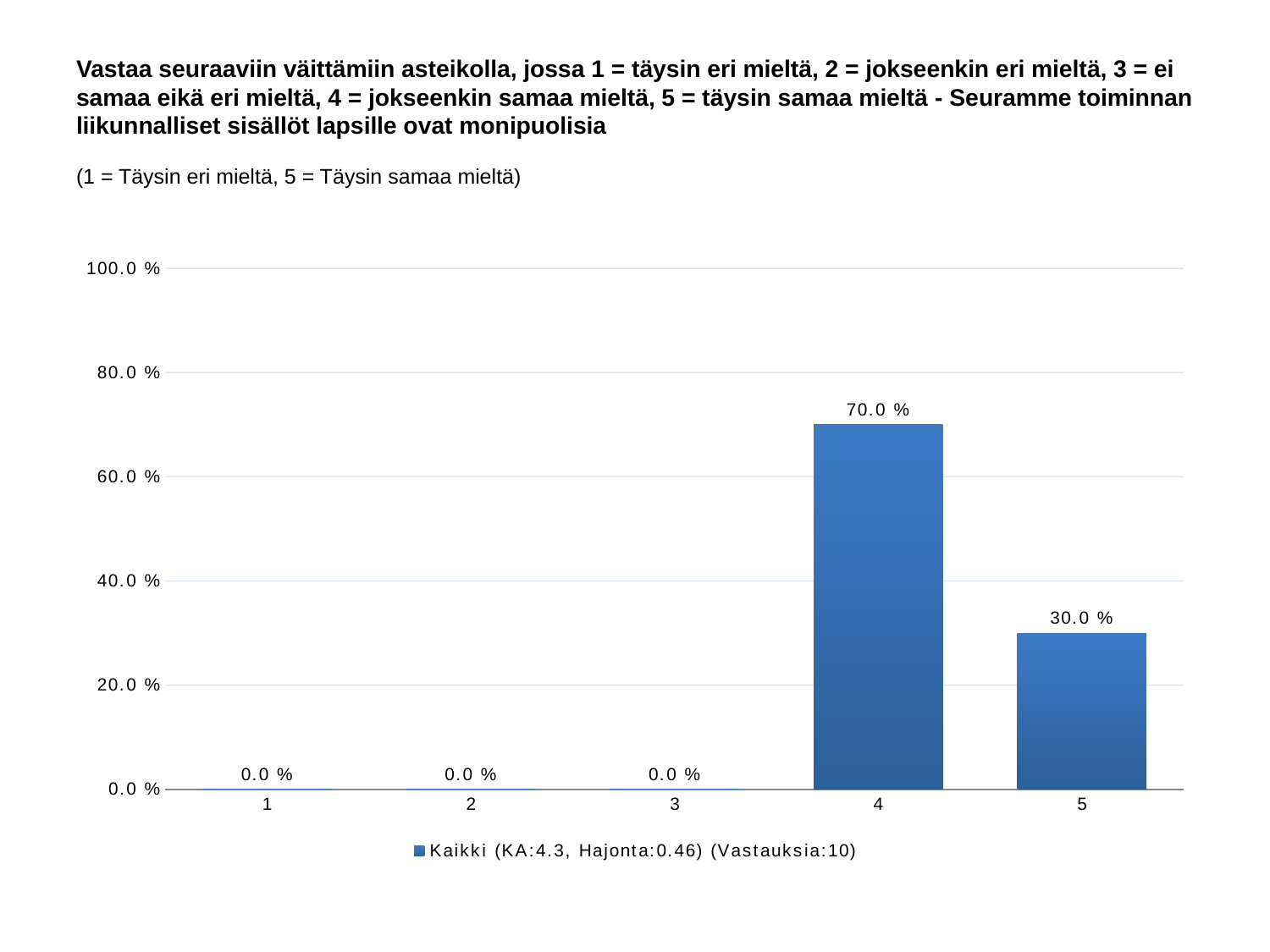
How many categories have a value of 0.0 %? 3 Is the value for category 4 greater or less than 60.0 %? greater What is the difference between the values for categories 4 and 5? 40.0 % How many series does the legend list? 1 What is the legend entry for the series? Kaikki (KA:4.3, Hajonta:0.46) (Vastauksia:10) What kind of chart is shown on the slide? bar chart What is the value for category 5? 30.0 % What is the value for category 1? 0.0 % What is the value for category 4? 70.0 % How many categories are shown on the x axis? 5 Which is larger, the value for category 4 or the value for category 5? 4 Which category has the highest value? 4